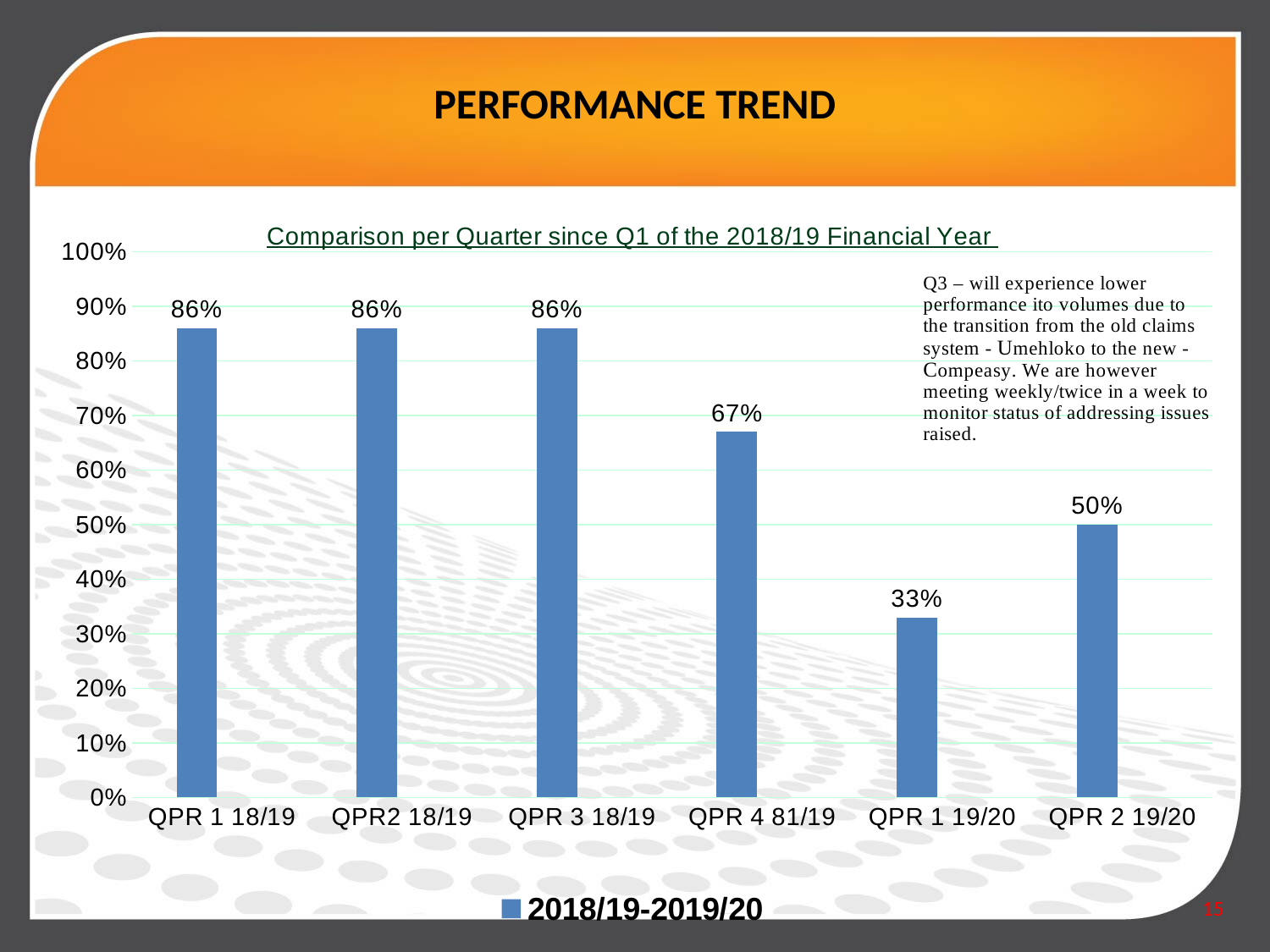
Which is larger, the value for QPR 4 81/19 or the value for QPR 2 19/20? QPR 4 81/19 Which quarter has the lowest value? QPR 1 19/20 What is the difference between the values for QPR 3 18/19 and QPR 4 81/19? 19% What is the difference between the values for QPR 2 19/20 and QPR 1 19/20? 17% What is the title of the chart? Comparison per Quarter since Q1 of the 2018/19 Financial Year How many series does the legend list? 1 What is the value for QPR 1 19/20? 33% What kind of chart is shown on the slide? Bar chart What is the value for QPR 3 18/19? 86% What is the value for QPR 4 81/19? 67% What is the value for QPR 2 19/20? 50% How many quarters are shown on the chart? 6